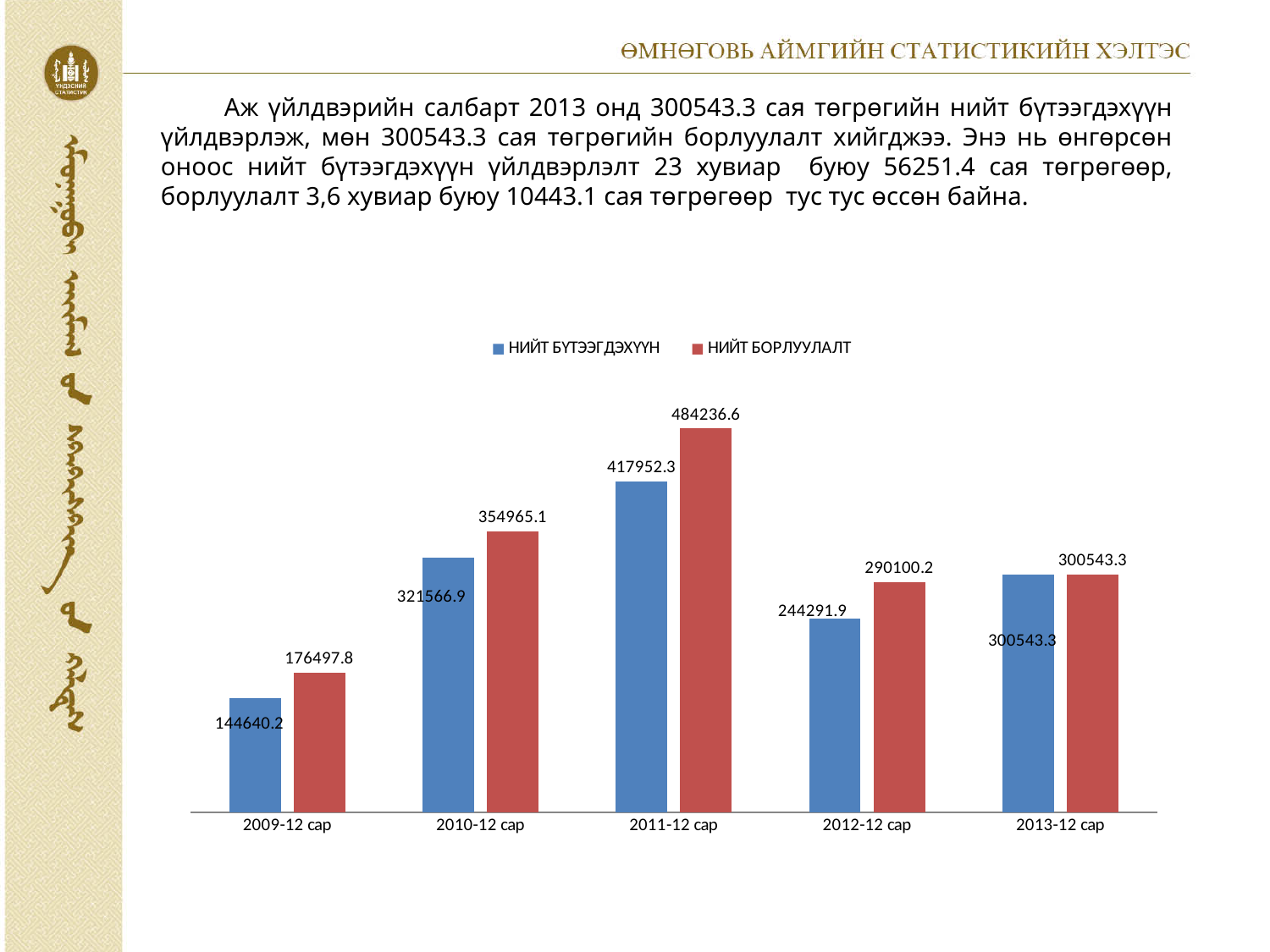
What is the value of НИЙТ БОРЛУУЛАЛТ for 2009-12 сар? 176497.8 What is the difference between НИЙТ БОРЛУУЛАЛТ and НИЙТ БҮТЭЭГДЭХҮҮН for 2011-12 сар? 66284.3 How many series does the legend list? 2 Which category has the lowest value for НИЙТ БҮТЭЭГДЭХҮҮН? 2009-12 сар Which is larger for 2010-12 сар: НИЙТ БҮТЭЭГДЭХҮҮН or НИЙТ БОРЛУУЛАЛТ? НИЙТ БОРЛУУЛАЛТ What kind of chart is shown on the slide? Bar chart What is the value of НИЙТ БҮТЭЭГДЭХҮҮН for 2011-12 сар? 417952.3 What is the difference between НИЙТ БОРЛУУЛАЛТ and НИЙТ БҮТЭЭГДЭХҮҮН for 2009-12 сар? 31857.6 Which category has the highest value for НИЙТ БОРЛУУЛАЛТ? 2011-12 сар What is the value of НИЙТ БОРЛУУЛАЛТ for 2012-12 сар? 290100.2 What is the value of НИЙТ БҮТЭЭГДЭХҮҮН for 2013-12 сар? 300543.3 How many categories are shown on the x axis? 5